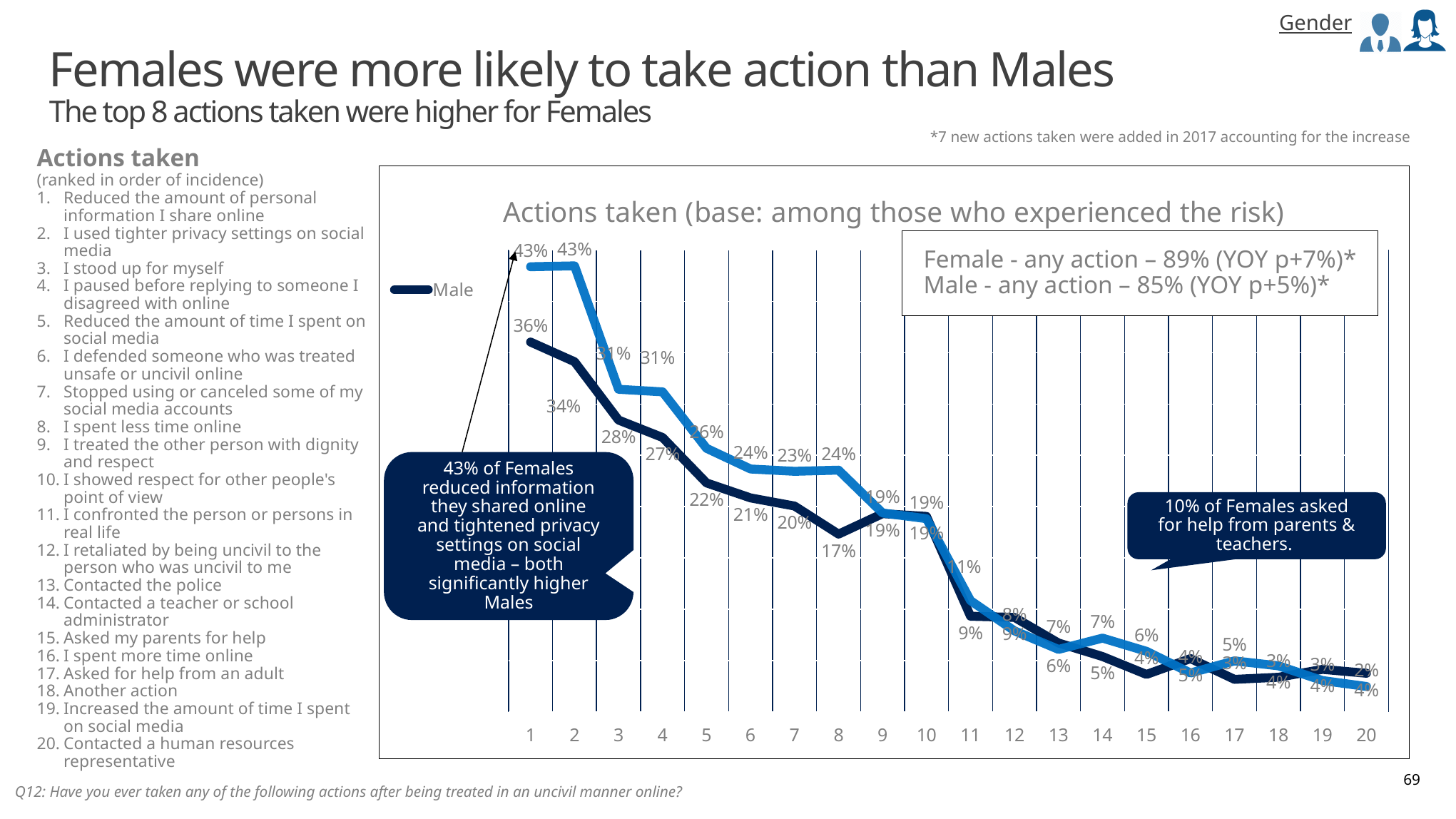
What is the Male value for action 1 in the chart? 36% For which action is the Male value highest? 1 What is the Female value for action 1 in the chart? 43% What is the Male value for action 14? 5% Do the values generally rise or fall moving from action 1 to action 20? Fall What is the Male value for action 8? 17% What is the difference between the Female and Male values for action 1? 7 percentage points What is the Female value for action 7? 23% What is the title of the chart? Actions taken (base: among those who experienced the risk) What kind of chart is shown on the slide? Line chart For action 4, which is larger, the Female value or the Male value? Female How many actions (categories) are plotted along the x axis of the chart? 20